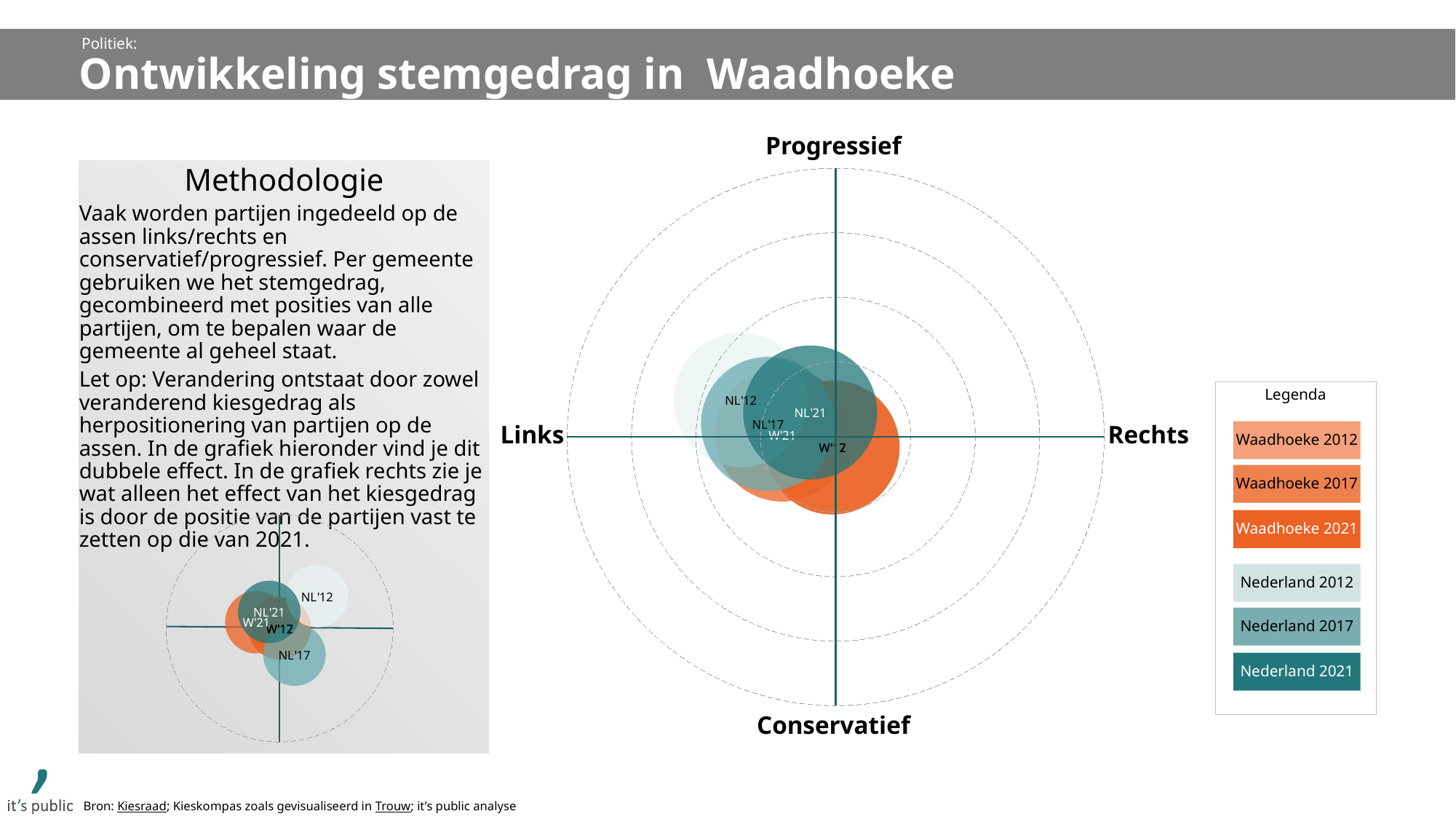
What kind of chart is the large chart on the right of the slide? Bubble chart How many entries does the legend (Legenda) list? 6 How many different years are shown in the legend for each of Waadhoeke and Nederland? 3 In the large chart, is the NL'12 bubble on the Progressief side or the Conservatief side of the horizontal axis? Progressief In the small chart at the bottom left, is the NL'17 bubble on the Progressief side or the Conservatief side of the horizontal axis? Conservatief In the large chart, is the NL'12 bubble on the Links side or the Rechts side of the vertical axis? Links What are the labels at the left and right ends of the horizontal axis of the large chart? Links and Rechts In the small chart at the bottom left, which labelled bubble is furthest to the right? NL'12 What are the labels at the top and bottom of the vertical axis of the large chart? Progressief and Conservatief